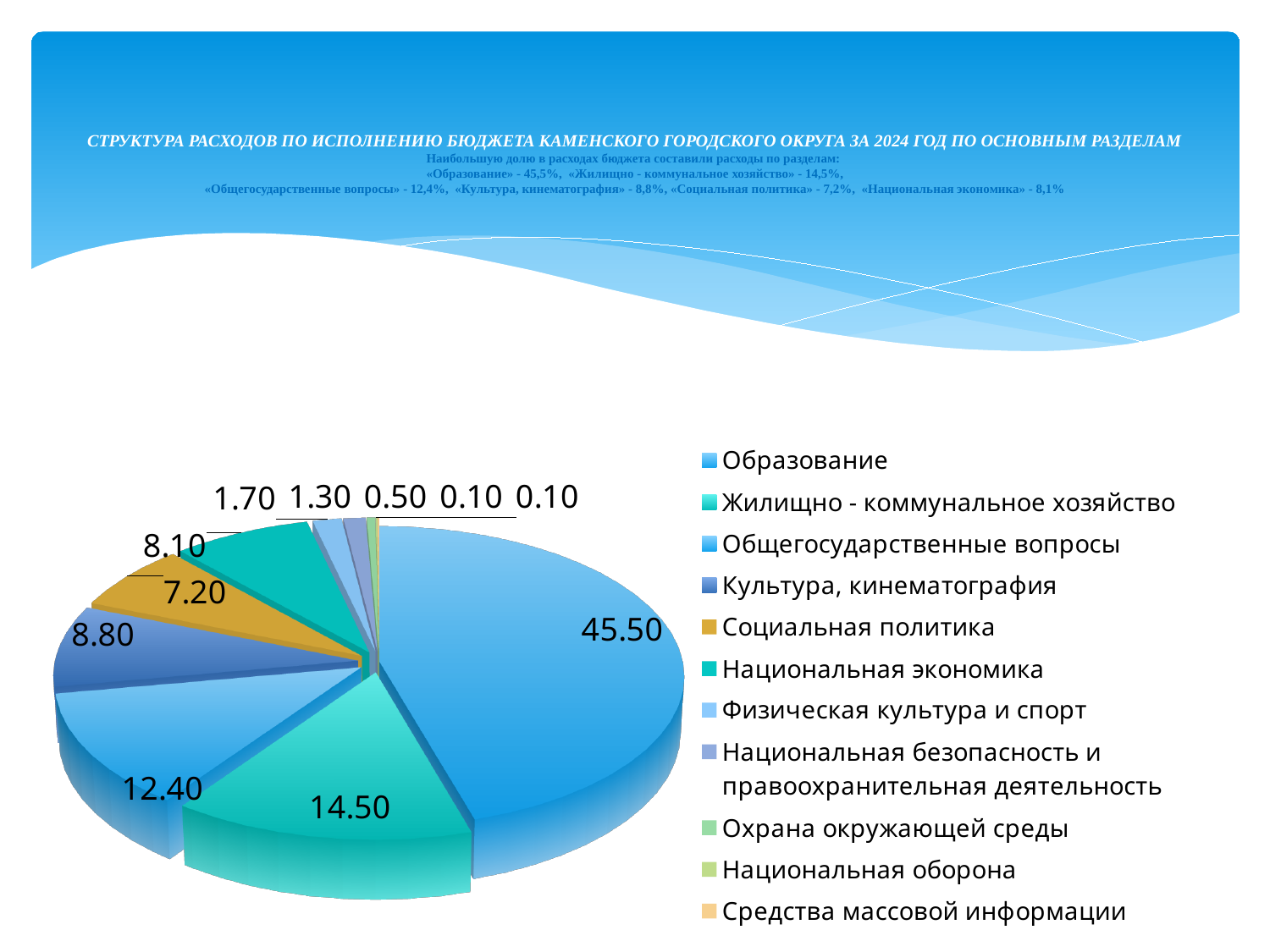
Which is larger, Культура, кинематография or Национальная экономика? Культура, кинематография What is the value shown for Образование? 45.50 What type of chart is shown on the slide? Pie chart What is the value shown for Жилищно - коммунальное хозяйство? 14.50 What is the value shown for Физическая культура и спорт? 1.70 What share of the pie does Национальная экономика represent? 8.10 What is the difference between the values for Образование and Жилищно - коммунальное хозяйство? 31.00 Which category has the largest slice of the pie? Образование What is the difference between the values for Общегосударственные вопросы and Культура, кинематография? 3.60 What is the value shown for Социальная политика? 7.20 How many categories are listed in the legend? 11 What is the value shown for Общегосударственные вопросы? 12.40